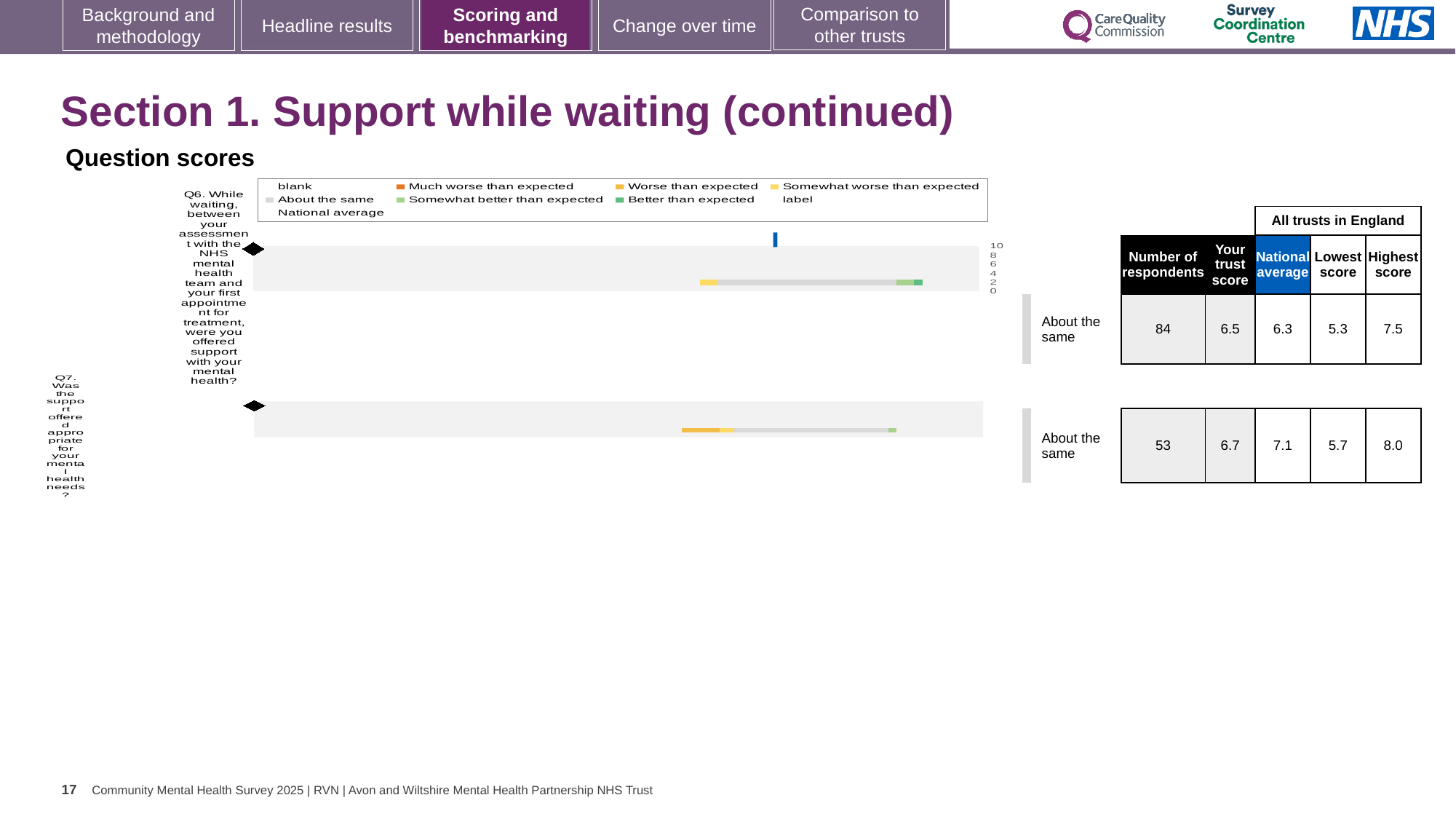
What is the national average score for Q7? 7.1 What is the 'Your trust score' for Q6 (support with your mental health while waiting)? 6.5 What is the national average score for Q6? 6.3 What benchmark category is shown for both Q6 and Q7? About the same For Q6, which is larger: the trust score or the national average? the trust score Which question had more respondents, Q6 or Q7? Q6 How many questions (bars) are plotted in the question scores chart? 2 What kind of chart is used to show the question scores on this slide? bar chart What is the difference between the highest score and the lowest score for Q7 across all trusts in England? 2.3 How many respondents answered Q6? 84 What is the 'Your trust score' for Q7 (was the support offered appropriate for your mental health needs)? 6.7 For Q7, which is larger: the trust score or the national average? the national average